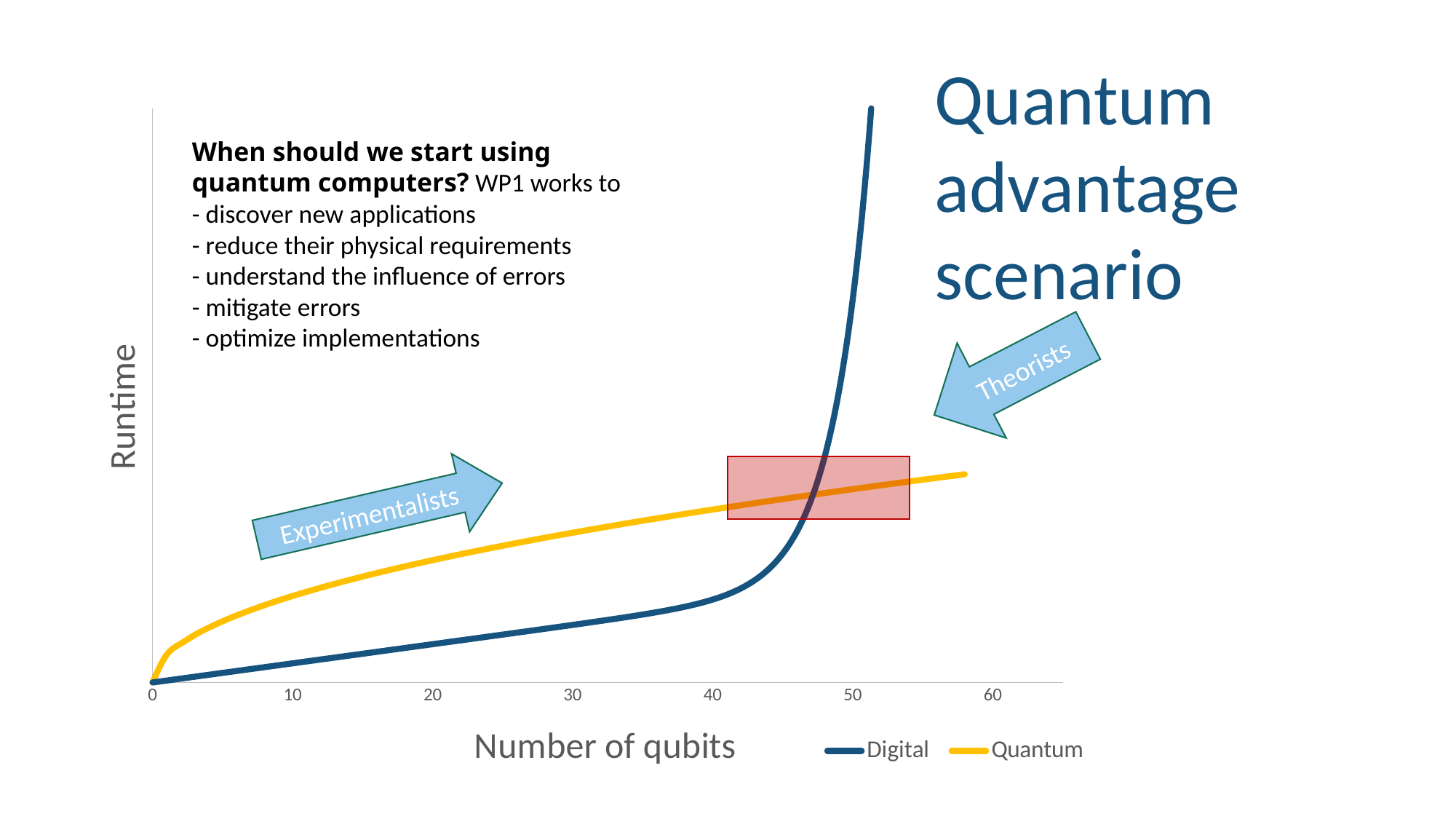
What is the label of the x axis? Number of qubits Which series rises more steeply at the right-hand end of the chart, Digital or Quantum? Digital Does the runtime of the Quantum series rise or fall as the number of qubits increases? rise Does the runtime of the Digital series rise or fall as the number of qubits increases? rise At 20 qubits, which series has the higher runtime, Digital or Quantum? Quantum What are the two series named in the legend? Digital and Quantum What is the label of the y axis? Runtime Is the number of qubits at which the Digital and Quantum lines cross greater or less than 40? greater How many series does the chart's legend list? 2 At 50 qubits, which series has the higher runtime, Digital or Quantum? Digital What kind of chart is shown on the slide? line chart